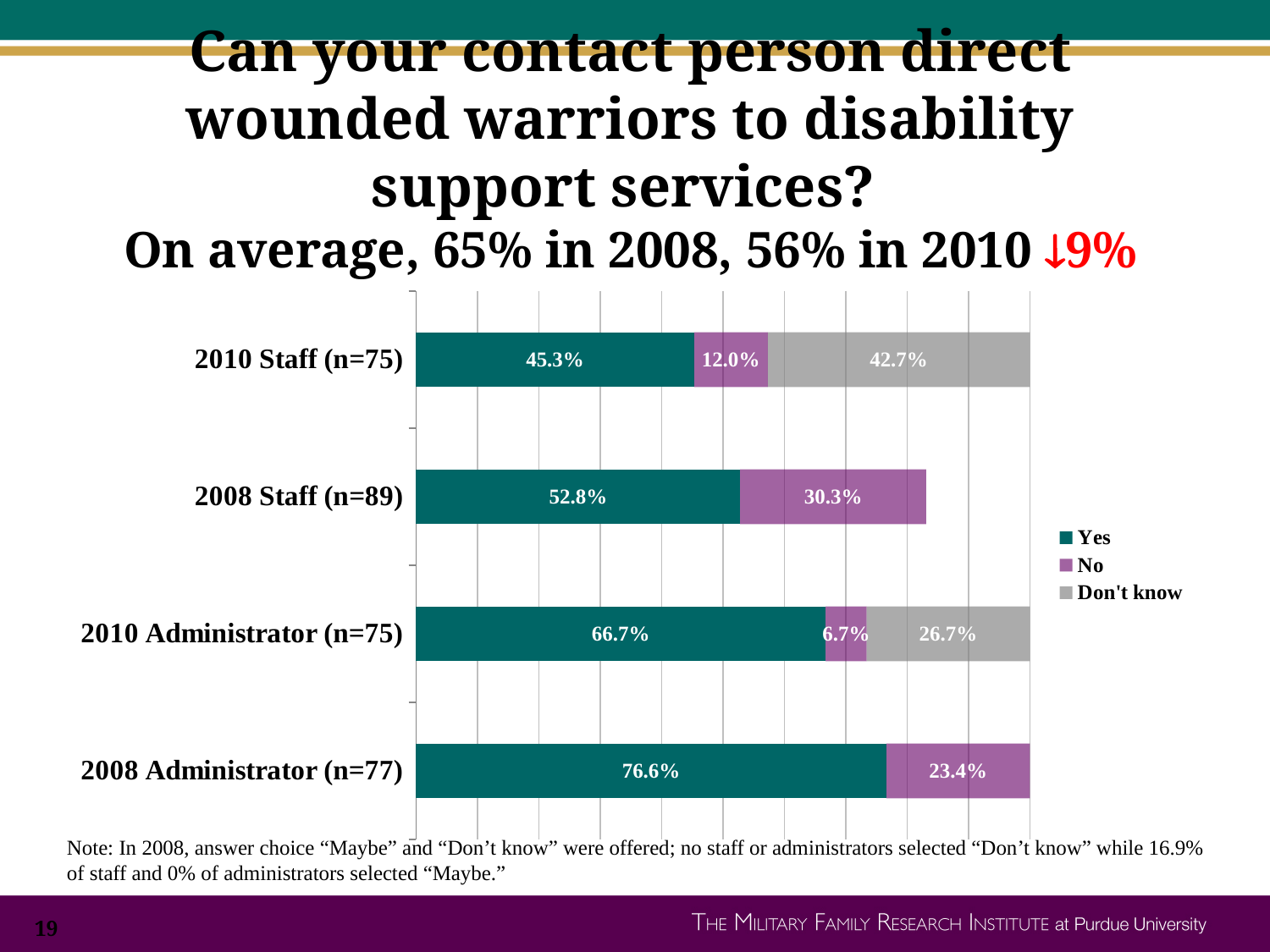
How many categories are shown on the chart? 4 Which series is shown in purple in the legend? No Which is larger: the No percentage for 2008 Staff (n=89) or the No percentage for 2010 Staff (n=75)? 2008 Staff (n=89) Which category has the lowest Yes percentage? 2010 Staff (n=75) What is the Don't know value for 2010 Administrator (n=75)? 26.7% Which category has the highest Yes percentage? 2008 Administrator (n=77) What is the difference between the Yes percentages for 2008 Administrator (n=77) and 2010 Administrator (n=75)? 9.9% How many series does the legend list? 3 What kind of chart is shown on the slide? Stacked bar chart What percentage of 2010 Staff (n=75) answered Yes? 45.3% What percentage of 2008 Administrator (n=77) answered No? 23.4% What is the total of the Yes and No segments for 2008 Staff (n=89)? 83.1%